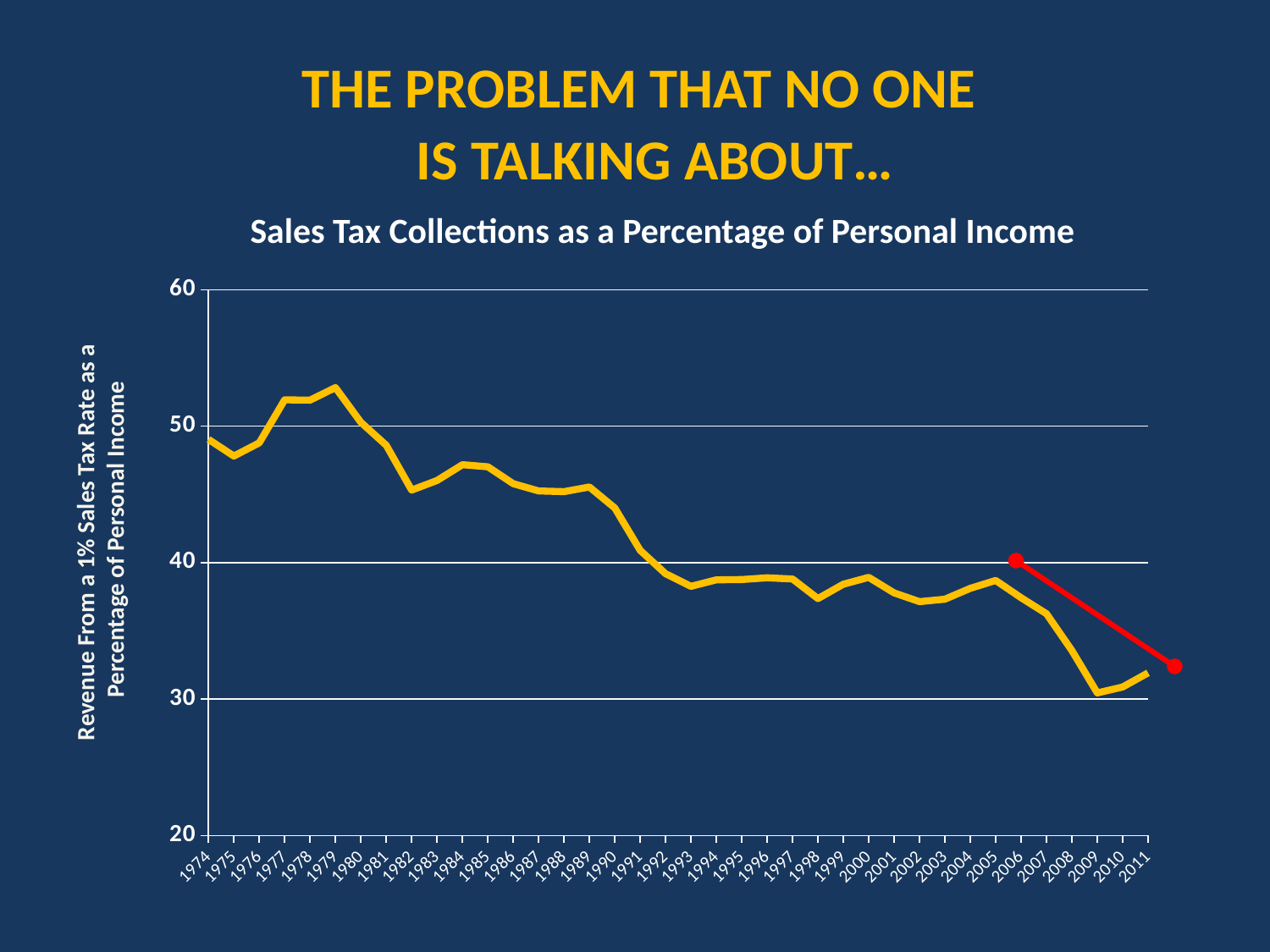
How many years are plotted along the x axis of the chart? 38 What kind of chart is shown on the slide? line chart Overall, do the values rise or fall from 1974 to 2011? fall Is the value for 1990 greater or less than 40? greater Which is larger, the value for 1977 or the value for 1982? 1977 Which year has the highest value on the chart? 1979 Is the value for 2009 greater or less than 35? less Which year has the lowest value on the chart? 2009 Is the value for 1979 greater or less than 50? greater What is the label on the vertical axis of the chart? Revenue From a 1% Sales Tax Rate as a Percentage of Personal Income What is the title of the chart? Sales Tax Collections as a Percentage of Personal Income